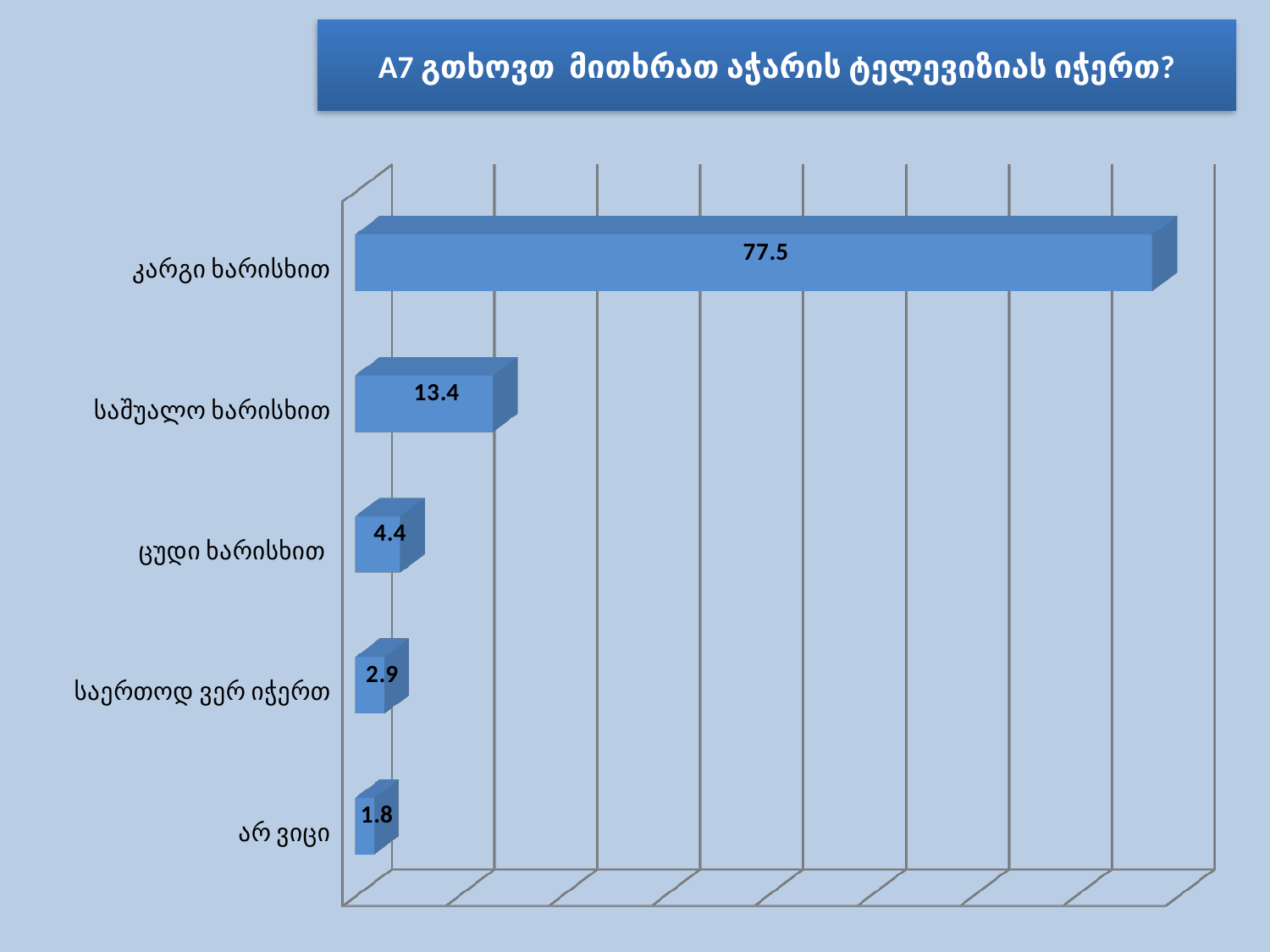
What is the difference between the values for კარგი ხარისხით and საშუალო ხარისხით? 64.1 Which category has the highest value? კარგი ხარისხით Which category has the lowest value? არ ვიცი How many categories are shown in the chart? 5 What is the value for არ ვიცი? 1.8 What is the value for კარგი ხარისხით? 77.5 What kind of chart is shown on the slide? bar chart Which is larger, the value for საშუალო ხარისხით or the value for ცუდი ხარისხით? საშუალო ხარისხით What is the value for საშუალო ხარისხით? 13.4 What is the value for ცუდი ხარისხით? 4.4 What is the value for საერთოდ ვერ იჭერთ? 2.9 What is the difference between the values for ცუდი ხარისხით and საერთოდ ვერ იჭერთ? 1.5